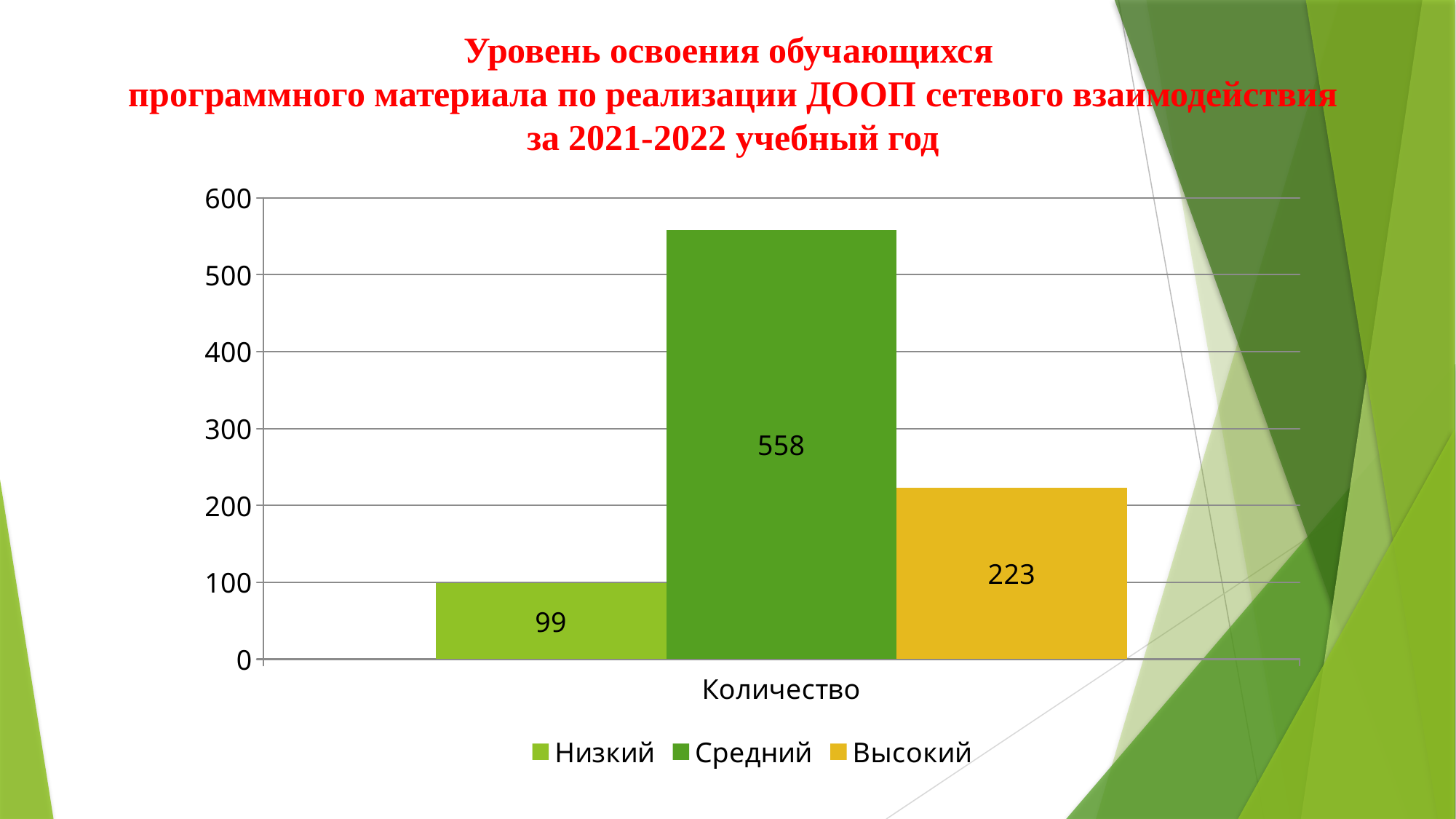
Is the value for Средний greater or less than 500? greater What is the label on the x axis category? Количество Which series has the lowest value? Низкий How many series does the legend list? 3 What is the value for Высокий? 223 What is the difference between the values for Средний and Высокий? 335 What is the value for Средний? 558 Which is larger, the value for Высокий or the value for Низкий? Высокий What kind of chart is shown on the slide? bar chart Which series has the highest value? Средний What is the value for Низкий? 99 What is the difference between the values for Высокий and Низкий? 124